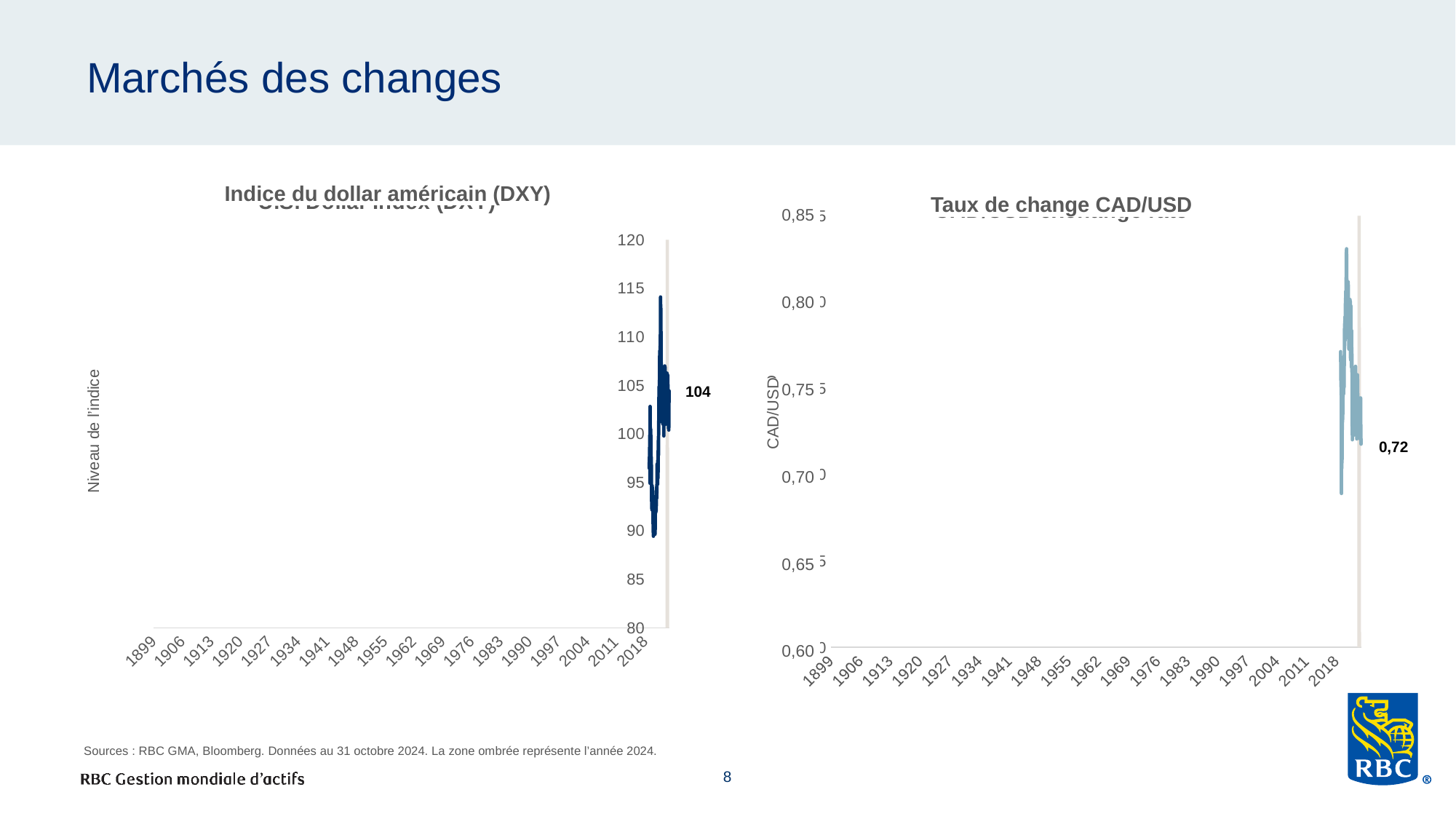
On the 'Indice du dollar américain (DXY)' chart, is the labelled end value greater or less than 110? less What kind of chart is the 'Indice du dollar américain (DXY)' chart? line chart On the 'Taux de change CAD/USD' chart, what is the value shown by the data label at the end of the line? 0,72 What is the y-axis title of the 'Indice du dollar américain (DXY)' chart? Niveau de l'indice On the 'Indice du dollar américain (DXY)' chart, is the labelled end value greater or less than 100? greater What is the y-axis title of the 'Taux de change CAD/USD' chart? CAD/USD What kind of chart is the 'Taux de change CAD/USD' chart? line chart On the 'Indice du dollar américain (DXY)' chart, is the lowest point of the line greater or less than 95? less On the 'Indice du dollar américain (DXY)' chart, what is the value shown by the data label at the end of the line? 104